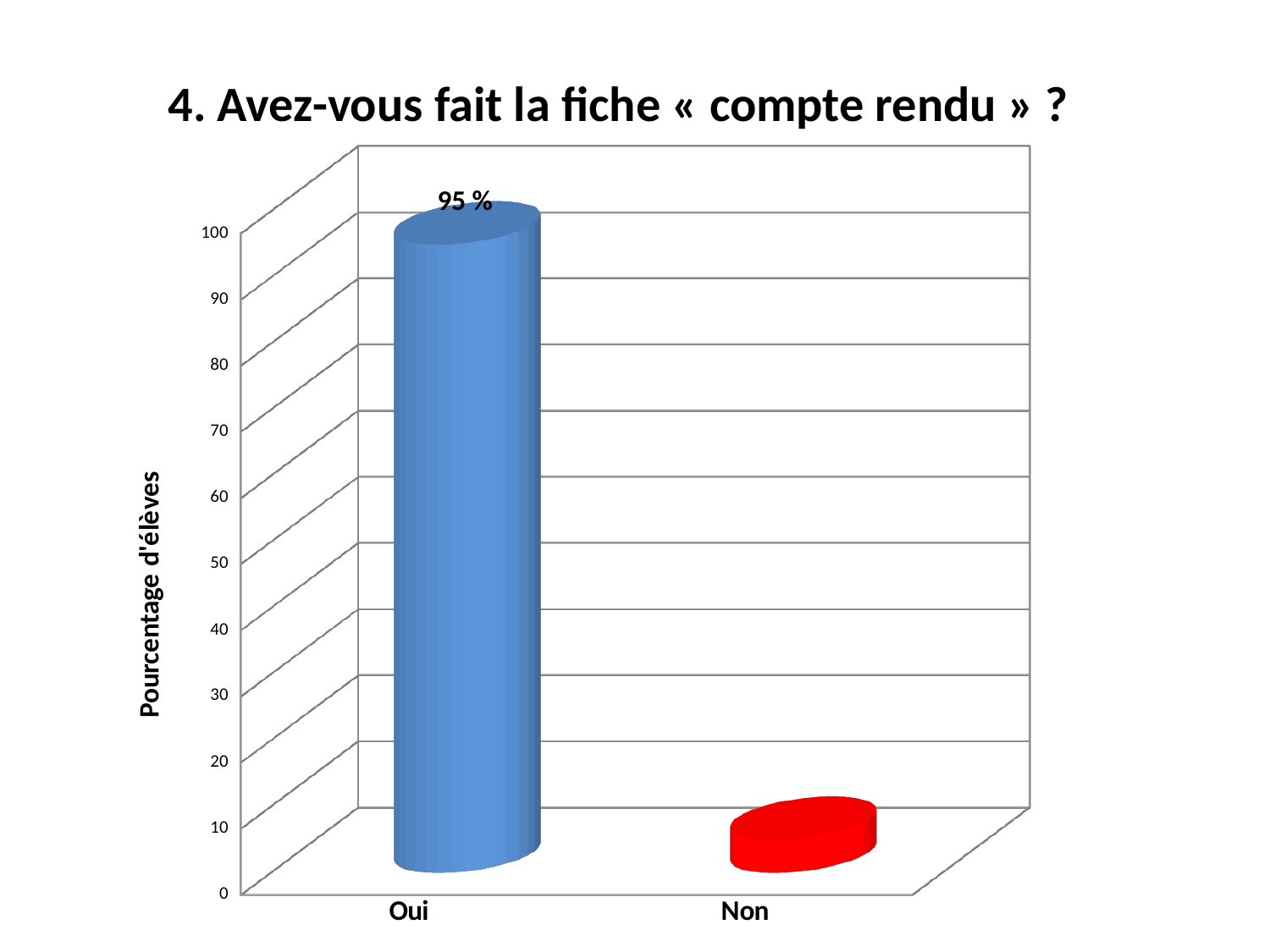
Which is larger, the value for "Oui" or the value for "Non"? Oui Is the value for "Non" greater or less than 20? less What kind of chart is shown on the slide? bar chart How many categories are shown on the x axis? 2 Which category has the highest value? Oui Which category has the lowest value? Non What is the value shown for "Oui"? 95 % Do the values rise or fall from "Oui" to "Non"? fall What is the label of the vertical axis? Pourcentage d'élèves Is the value for "Oui" greater or less than 90? greater What is the title of the chart? 4. Avez-vous fait la fiche « compte rendu » ?